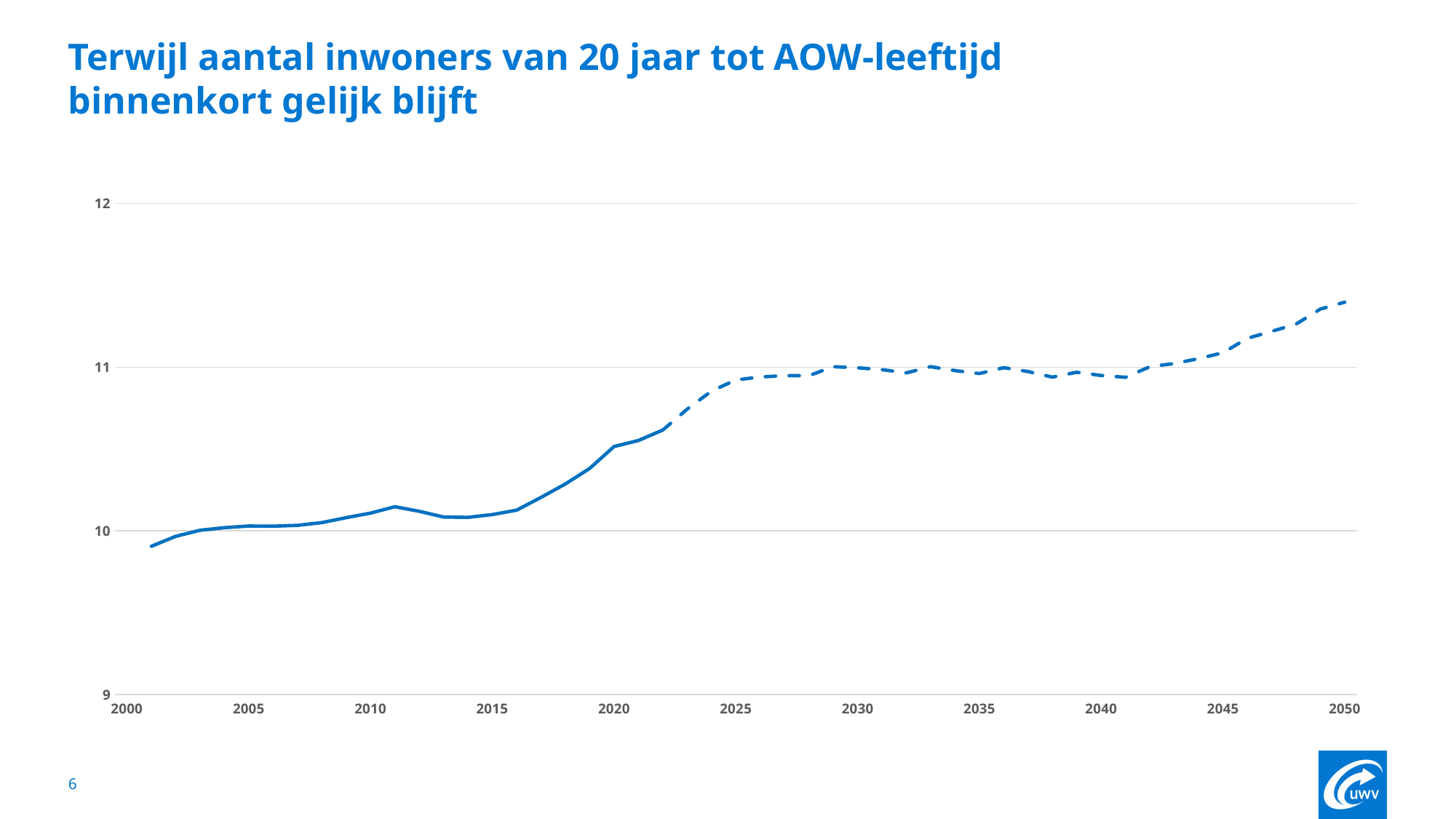
Is the value for 2050 greater or less than 11? greater How is the part of the line after about 2022 drawn differently from the earlier part? dashed Does the line generally rise or fall from 2000 to 2050? rise In which year does the line reach its highest value? 2050 Which is larger, the value for 2020 or the value for 2010? 2020 What kind of chart is shown on the slide? line chart Is the value for 2010 greater or less than 11? less Is the value for 2001 greater or less than 10? less What is the title of the slide? Terwijl aantal inwoners van 20 jaar tot AOW-leeftijd binnenkort gelijk blijft In which year is the line at its lowest value? 2001